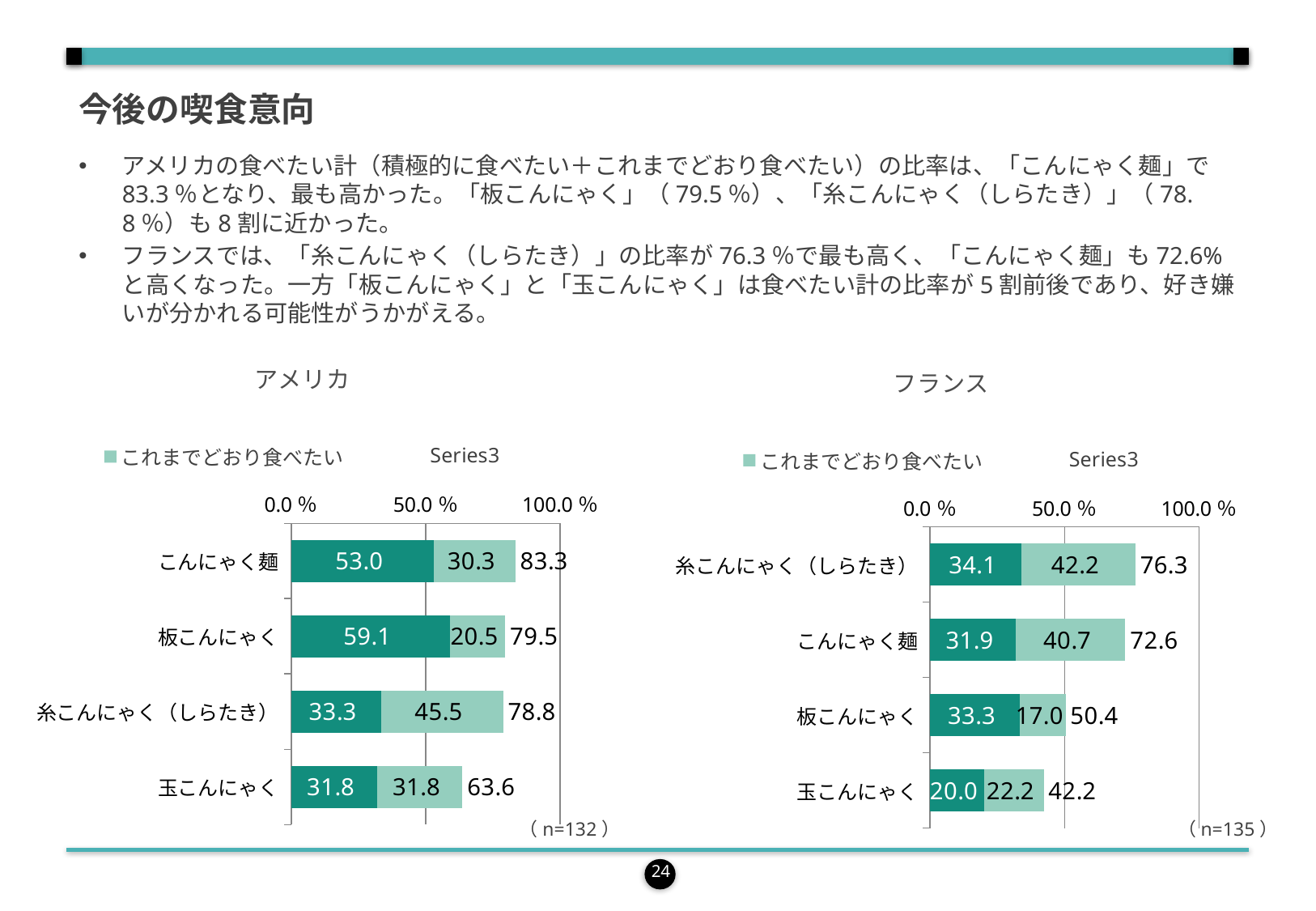
In the アメリカ chart, what is the value of the これまでどおり食べたい segment for 糸こんにゃく（しらたき）? 45.5 In the アメリカ chart, what is the total value shown for こんにゃく麺? 83.3 In the アメリカ chart, how many categories are plotted? 4 In the アメリカ chart, which category has the lowest total? 玉こんにゃく In the フランス chart, is the total for 玉こんにゃく greater or less than 50.0 %? less In the アメリカ chart, what is the difference between the totals for こんにゃく麺 and 玉こんにゃく? 19.7 What is the sample size shown below the アメリカ chart? n=132 In the フランス chart, what is the value of the これまでどおり食べたい segment for こんにゃく麺? 40.7 In the フランス chart, what is the total value shown for 板こんにゃく? 50.4 What type of chart is the フランス chart? stacked bar chart In the フランス chart, which category has the highest total? 糸こんにゃく（しらたき） Which is larger: the total for 板こんにゃく in the アメリカ chart or in the フランス chart? アメリカ